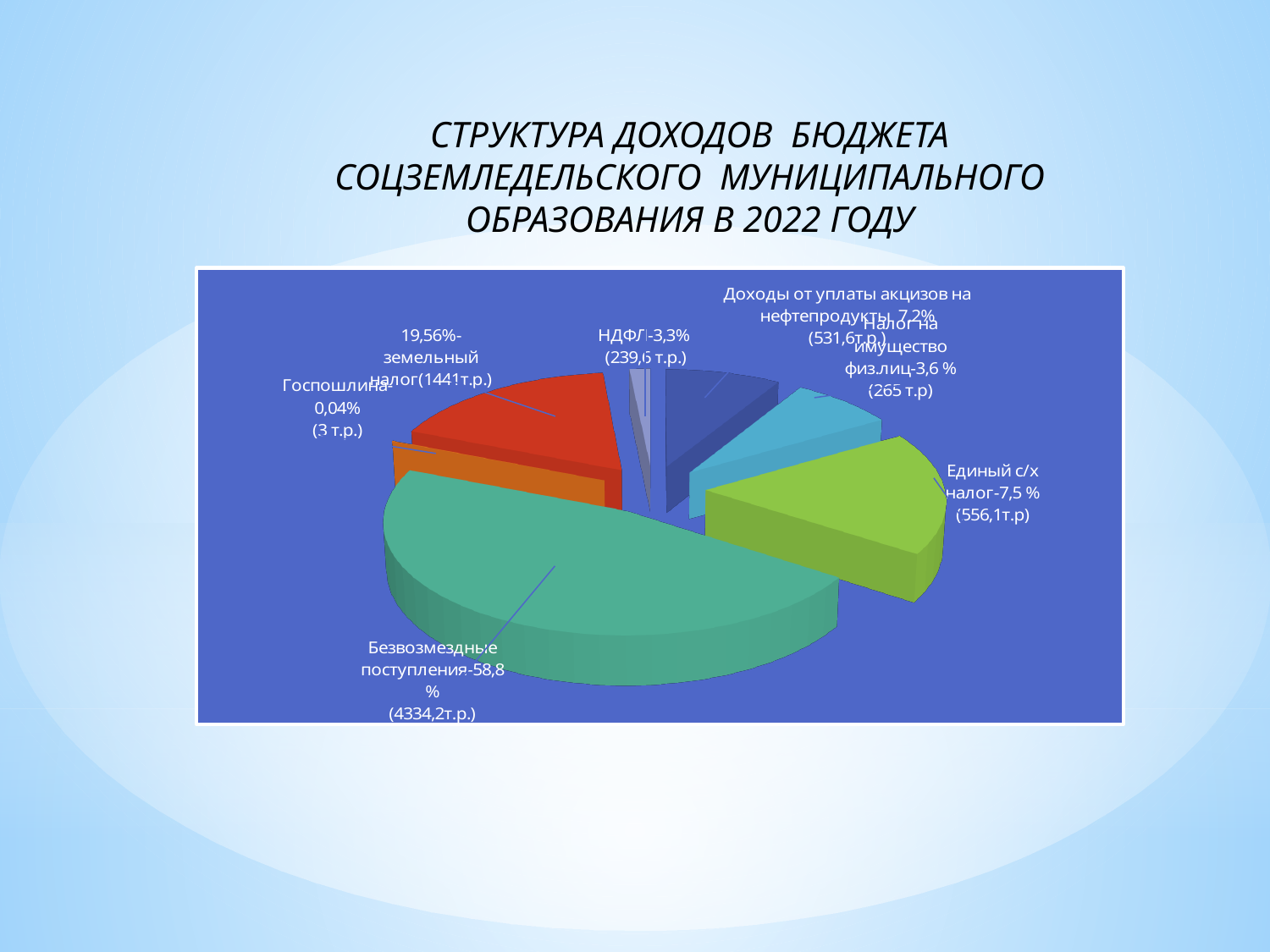
What is the value in thousand rubles for Безвозмездные поступления? 4334,2т.р. What percentage share does Единый с/х налог have? 7,5 % Which category has the smallest slice of the pie? Госпошлина What is the difference in thousand rubles between Налог на имущество физ.лиц (265 т.р) and НДФЛ (239,6 т.р.)? 25,4 т.р. Which category has the largest slice of the pie? Безвозмездные поступления What year does the chart title say the budget income structure refers to? 2022 What is the value for земельный налог? 1441т.р. Which is larger: Единый с/х налог or Доходы от уплаты акцизов на нефтепродукты? Единый с/х налог What share of the pie does Безвозмездные поступления represent? 58,8 % What kind of chart is shown on the slide? Pie chart How many slices does the pie chart have? 7 What is the value for НДФЛ? 239,6 т.р.